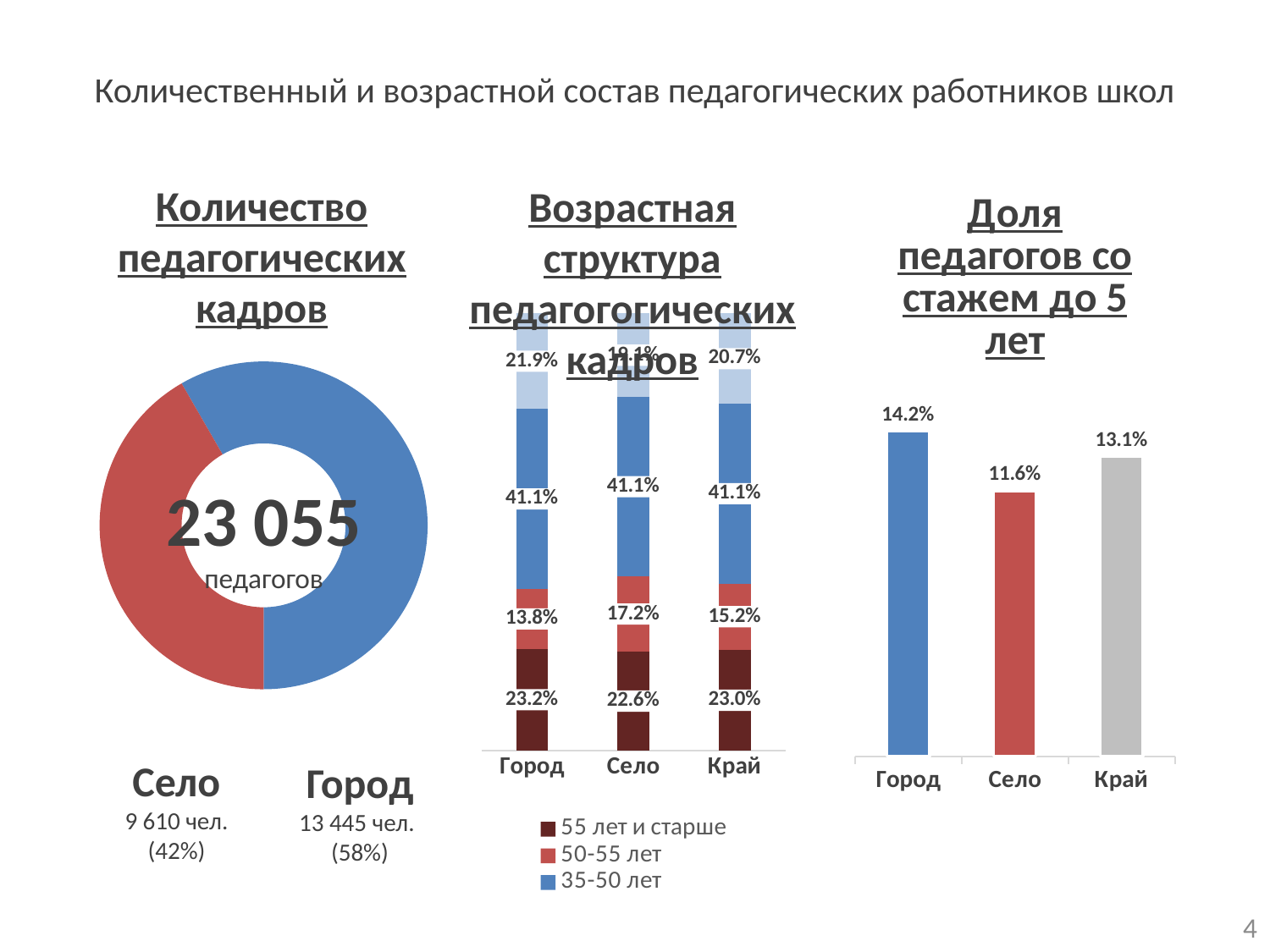
In the chart 'Возрастная структура педагогогических кадров', how many series does the legend list? 3 What kind of chart is 'Количество педагогических кадров'? Donut chart In the chart 'Доля педагогов со стажем до 5 лет', which category has the highest value? Город In the chart 'Доля педагогов со стажем до 5 лет', what is the difference between the values for Город and Край? 1.1% In the chart 'Возрастная структура педагогогических кадров', what is the value of the '55 лет и старше' segment for Село? 22.6% In the chart 'Доля педагогов со стажем до 5 лет', which category has the lowest value? Село In the chart 'Количество педагогических кадров', what share of the total does Город represent? 58% In the chart 'Доля педагогов со стажем до 5 лет', what is the value for Село? 11.6% In the chart 'Количество педагогических кадров', what is the value for Село? 9 610 чел. (42%) In the chart 'Доля педагогов со стажем до 5 лет', what is the value for Город? 14.2% In the chart 'Возрастная структура педагогогических кадров', which category has the highest value for the '50-55 лет' segment? Село In the chart 'Возрастная структура педагогогических кадров', what is the value of the '50-55 лет' segment for Край? 15.2%